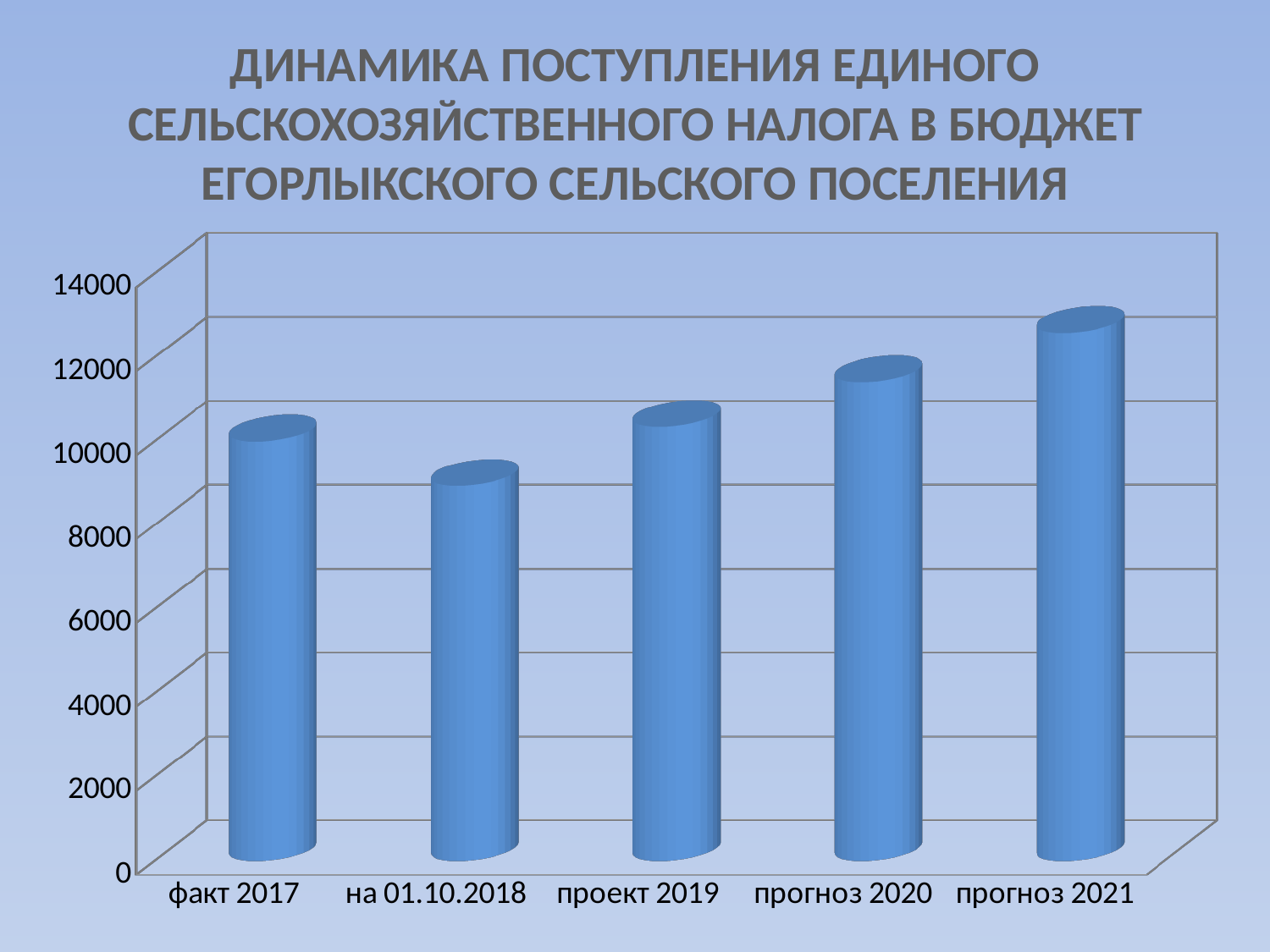
How many categories are shown on the x axis of the chart? 5 Which category has the highest value in the chart? прогноз 2021 Which is larger: the value for прогноз 2020 or the value for факт 2017? прогноз 2020 Is the value for прогноз 2020 greater or less than 10000? greater Do the values rise or fall from проект 2019 to прогноз 2021? rise Is the value for прогноз 2021 greater or less than 12000? greater Which is larger: the value for на 01.10.2018 or the value for проект 2019? проект 2019 What is the title of the chart on the slide? ДИНАМИКА ПОСТУПЛЕНИЯ ЕДИНОГО СЕЛЬСКОХОЗЯЙСТВЕННОГО НАЛОГА В БЮДЖЕТ ЕГОРЛЫКСКОГО СЕЛЬСКОГО ПОСЕЛЕНИЯ Is the value for на 01.10.2018 greater or less than 8000? greater Which category has the lowest value in the chart? на 01.10.2018 What kind of chart is shown on the slide? bar chart